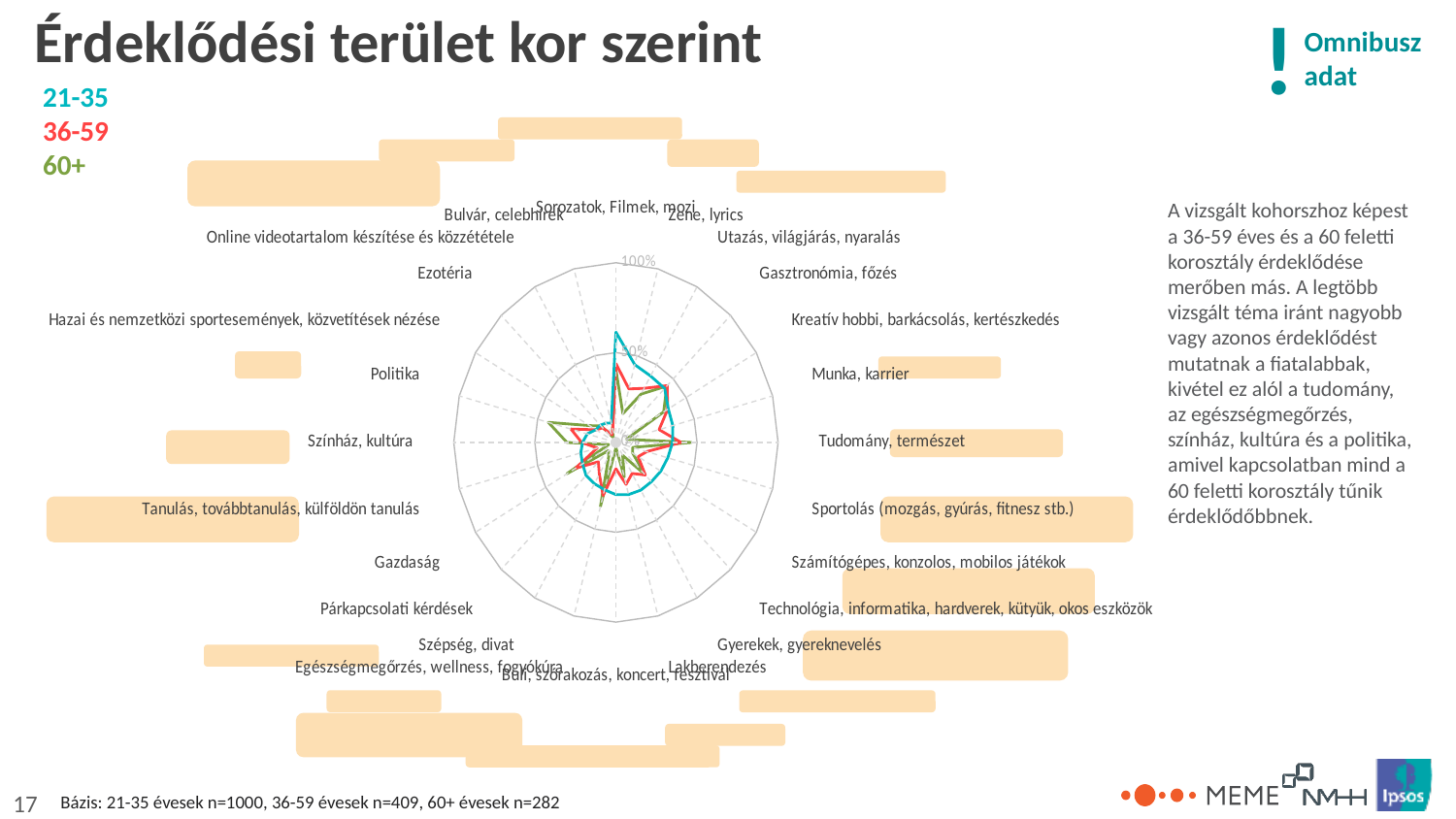
How many series does the legend list? 3 What are the three series shown in the legend? 21-35, 36-59, 60+ Is the value for Ezotéria for the 21-35 group greater or less than 50%? less Which age group has the highest value for Sorozatok, Filmek, mozi? 21-35 How many interest categories are plotted around the radar chart? 24 Which age group has the highest value for Politika? 60+ What kind of chart is shown on the slide? radar chart Is the value for Gazdaság for the 36-59 group greater or less than 50%? less What is the title of the chart? Érdeklődési terület kor szerint Is the value for Sorozatok, Filmek, mozi for the 60+ group greater or less than 50%? less